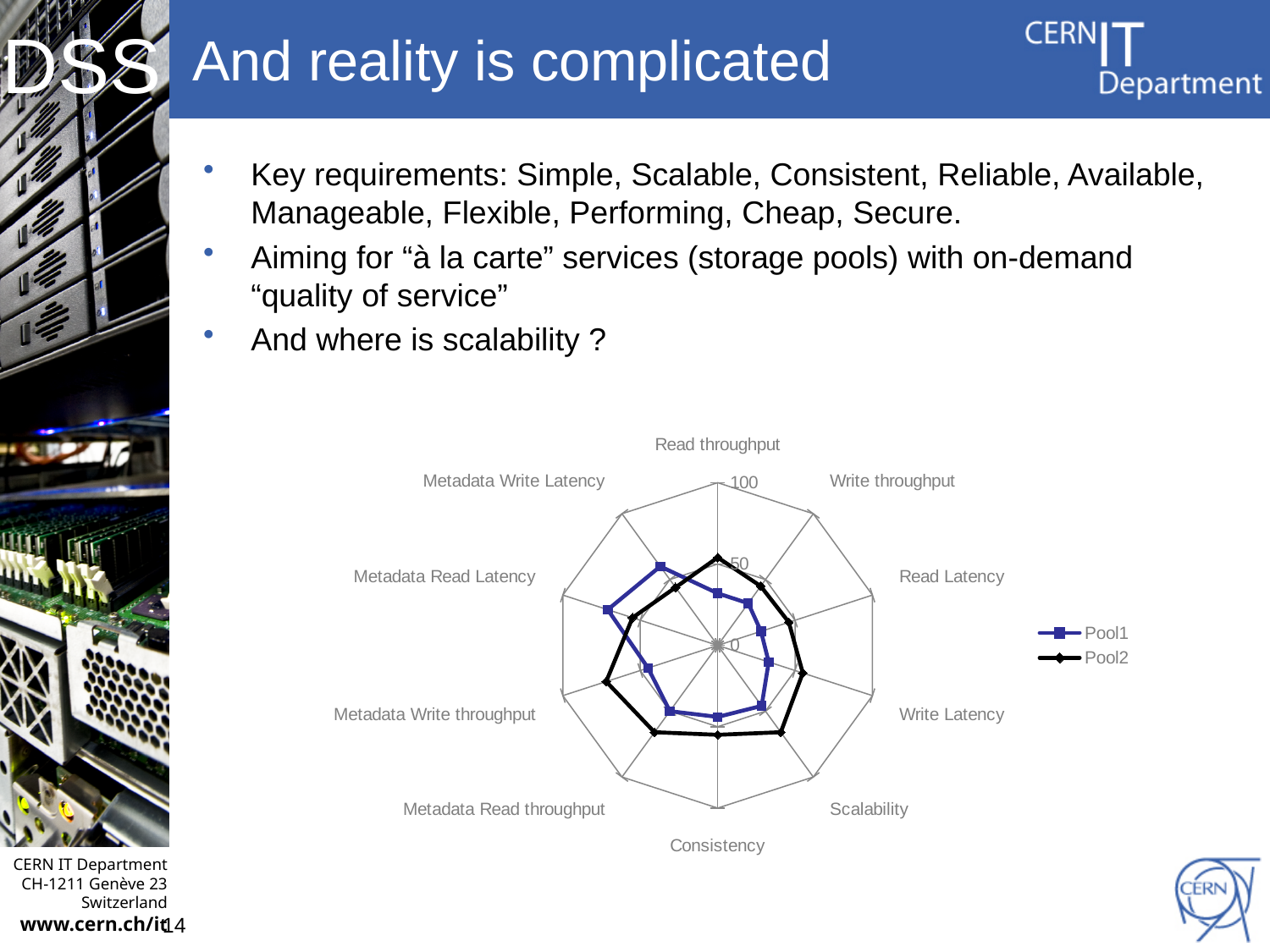
Is the value of Pool1 for Write throughput greater or less than 50? less For Metadata Read Latency, which series has the larger value, Pool1 or Pool2? Pool1 What is the maximum value shown on the radar chart's axis scale? 100 What kind of chart is shown on the slide? Radar chart Is the value of Pool2 for Scalability greater or less than 50? greater Is the value of Pool2 for Metadata Write throughput greater or less than 50? greater Which series is drawn in blue with square markers? Pool1 How many series does the chart legend list? 2 How many categories (axes) does the radar chart have? 10 For Scalability, which series has the larger value, Pool1 or Pool2? Pool2